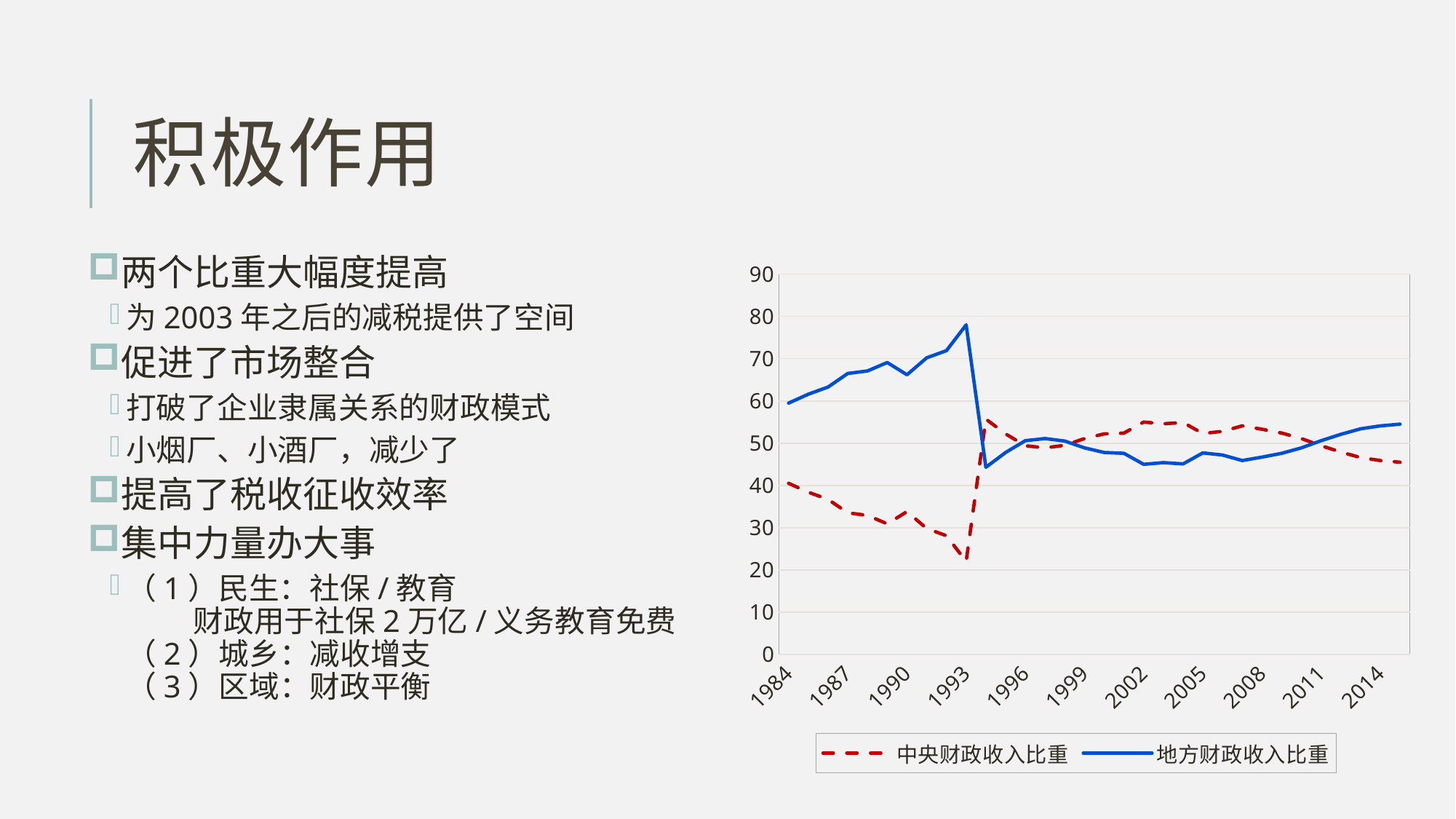
Which series is drawn as a solid blue line? 地方财政收入比重 In which year does 中央财政收入比重 reach its lowest value? 1993 Does 中央财政收入比重 rise or fall from 1984 to 1993? fall How many series does the chart's legend list? 2 Is the value of 地方财政收入比重 in 1984 greater or less than 50? greater Is the value of 中央财政收入比重 in 1984 greater or less than 50? less Which series is drawn as a red dashed line? 中央财政收入比重 In which year does 地方财政收入比重 reach its highest value? 1993 What kind of chart is shown on the slide? line chart In 2002, which series has the larger value, 中央财政收入比重 or 地方财政收入比重? 中央财政收入比重 Is the value of 地方财政收入比重 in 1993 greater or less than 70? greater